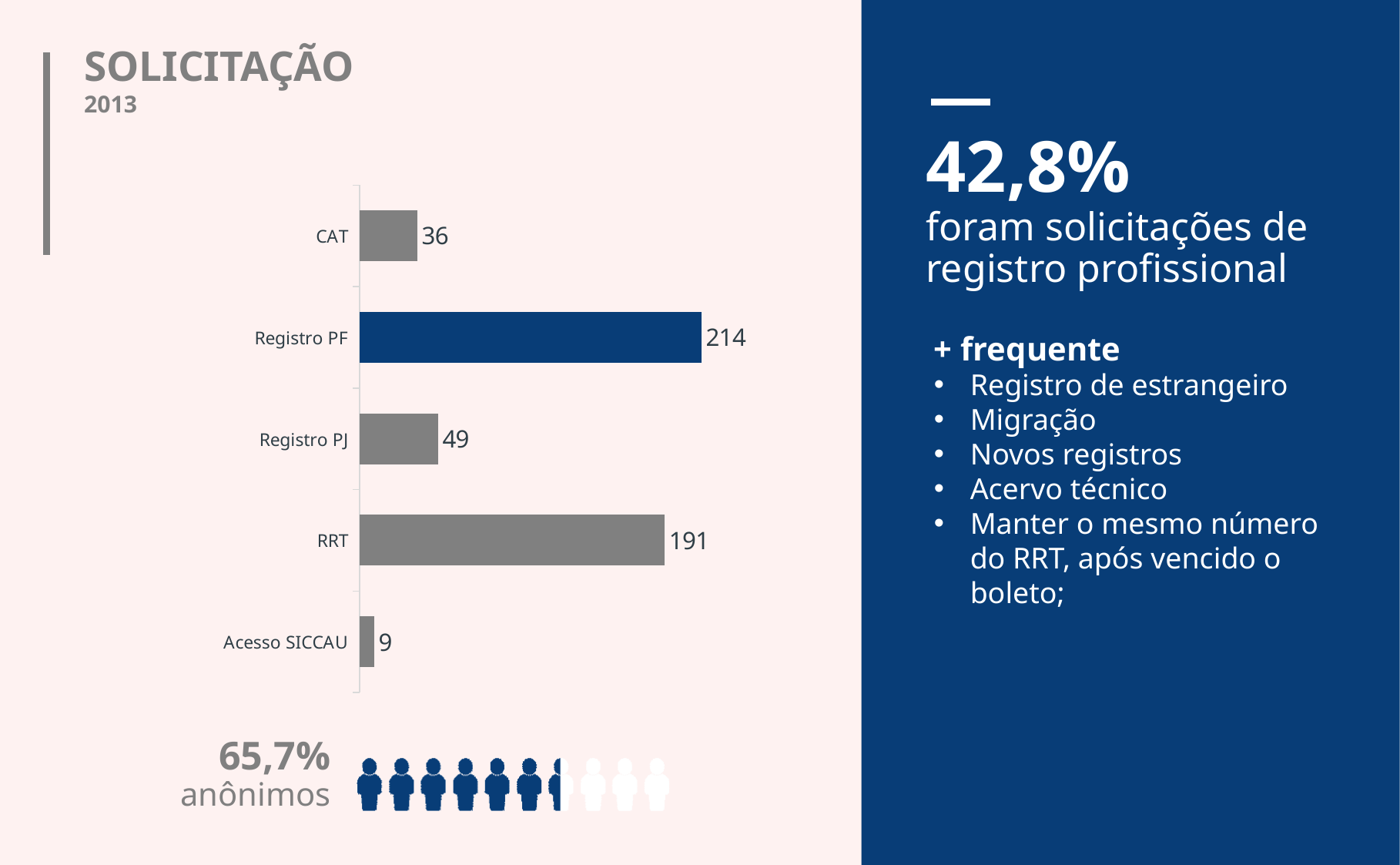
What is the value for Registro PF? 214 How many categories are shown in the bar chart? 5 Which category has the lowest value? Acesso SICCAU What kind of chart is shown on the slide? Bar chart Which bar is coloured dark blue instead of grey? Registro PF What is the total of all five bar values? 499 What is the value for RRT? 191 What is the value for CAT? 36 What is the value for Acesso SICCAU? 9 Which is larger, the value for Registro PJ or the value for CAT? Registro PJ Which category has the highest value? Registro PF What is the difference between the values for Registro PF and RRT? 23